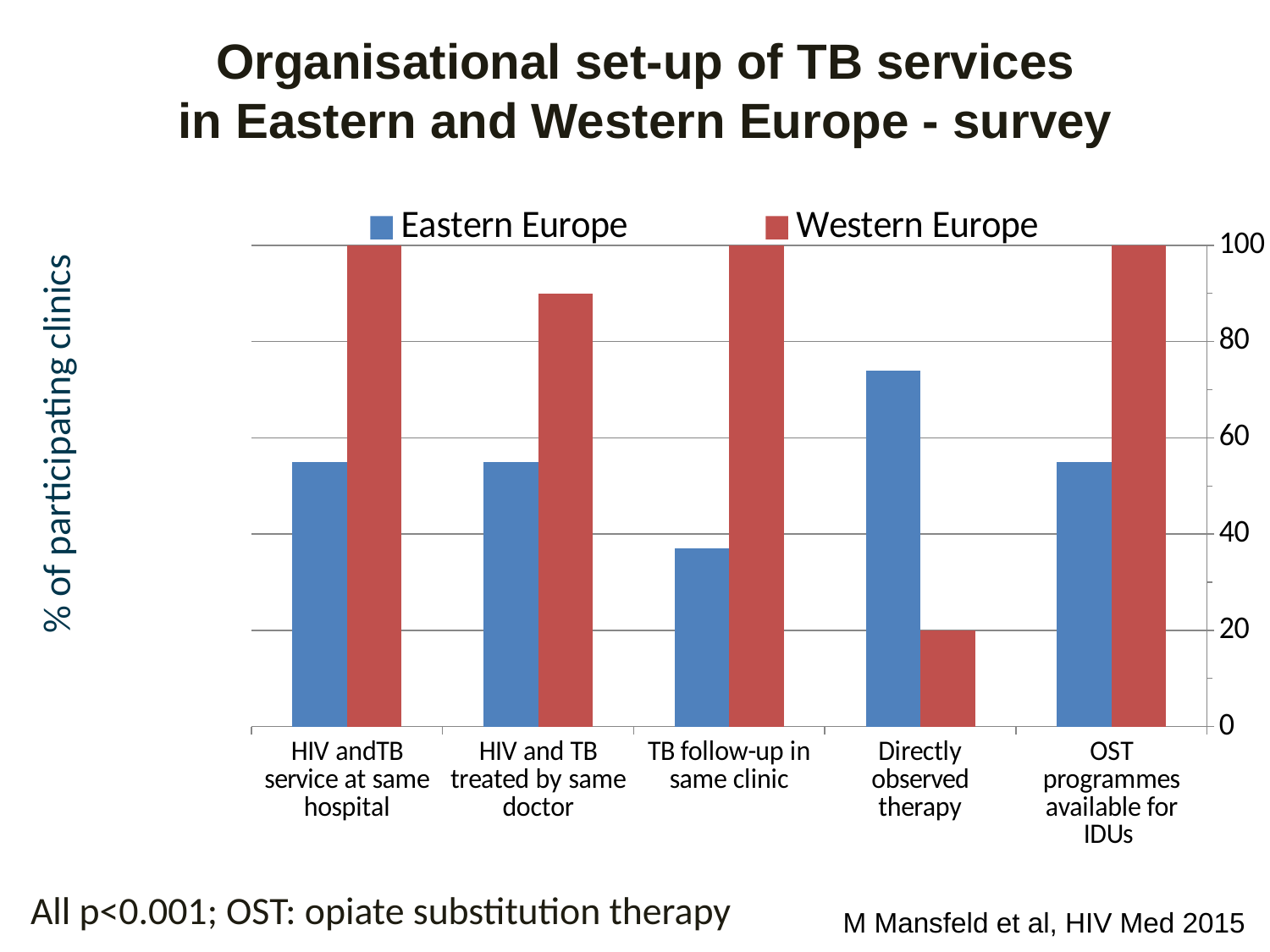
For 'HIV and TB treated by same doctor', which series has the larger value, Eastern Europe or Western Europe? Western Europe How many series does the legend list? 2 What is the Western Europe value for 'Directly observed therapy'? 20 For which category is the Eastern Europe value highest? Directly observed therapy Is the Eastern Europe value for 'Directly observed therapy' greater or less than 60? greater Is the Eastern Europe value for 'TB follow-up in same clinic' greater or less than 40? less For which category is the Eastern Europe value lowest? TB follow-up in same clinic How many categories are shown on the x axis? 5 What is the Western Europe value for 'OST programmes available for IDUs'? 100 What is the Western Europe value for 'TB follow-up in same clinic'? 100 What type of chart is shown on the slide? bar chart For which category is the Western Europe value lowest? Directly observed therapy